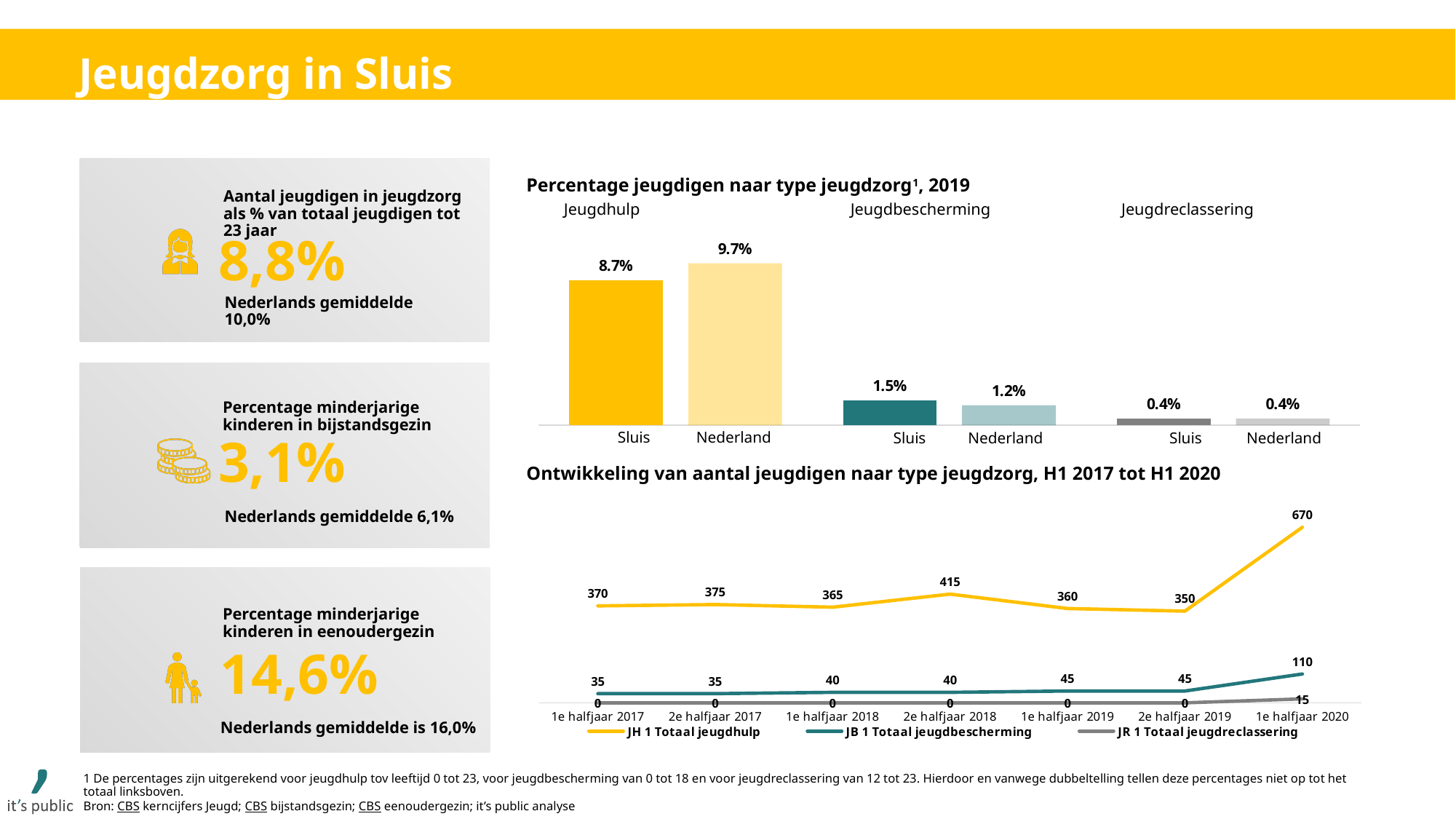
In the chart 'Ontwikkeling van aantal jeugdigen naar type jeugdzorg', what is the value of JB 1 Totaal jeugdbescherming in 2e halfjaar 2018? 40 How many series does the legend of the chart 'Ontwikkeling van aantal jeugdigen naar type jeugdzorg' list? 3 In the chart 'Ontwikkeling van aantal jeugdigen naar type jeugdzorg', how much did JH 1 Totaal jeugdhulp increase from 2e halfjaar 2019 to 1e halfjaar 2020? 320 In the chart 'Percentage jeugdigen naar type jeugdzorg, 2019', what is the Jeugdbescherming percentage for Nederland? 1.2% How many time periods are shown on the x axis of the chart 'Ontwikkeling van aantal jeugdigen naar type jeugdzorg'? 7 In the chart 'Ontwikkeling van aantal jeugdigen naar type jeugdzorg', what is the value of JH 1 Totaal jeugdhulp in 1e halfjaar 2020? 670 In the chart 'Ontwikkeling van aantal jeugdigen naar type jeugdzorg', in which period is JH 1 Totaal jeugdhulp lowest? 2e halfjaar 2019 In the chart 'Percentage jeugdigen naar type jeugdzorg, 2019', what is the Jeugdhulp percentage for Sluis? 8.7% What kind of chart is 'Percentage jeugdigen naar type jeugdzorg, 2019'? Bar chart In the chart 'Percentage jeugdigen naar type jeugdzorg, 2019', which bar is the highest? Nederland (Jeugdhulp) In the chart 'Percentage jeugdigen naar type jeugdzorg, 2019', which is larger for Jeugdbescherming: Sluis or Nederland? Sluis In the chart 'Percentage jeugdigen naar type jeugdzorg, 2019', what is the difference between the Jeugdhulp percentages for Nederland and Sluis? 1.0%